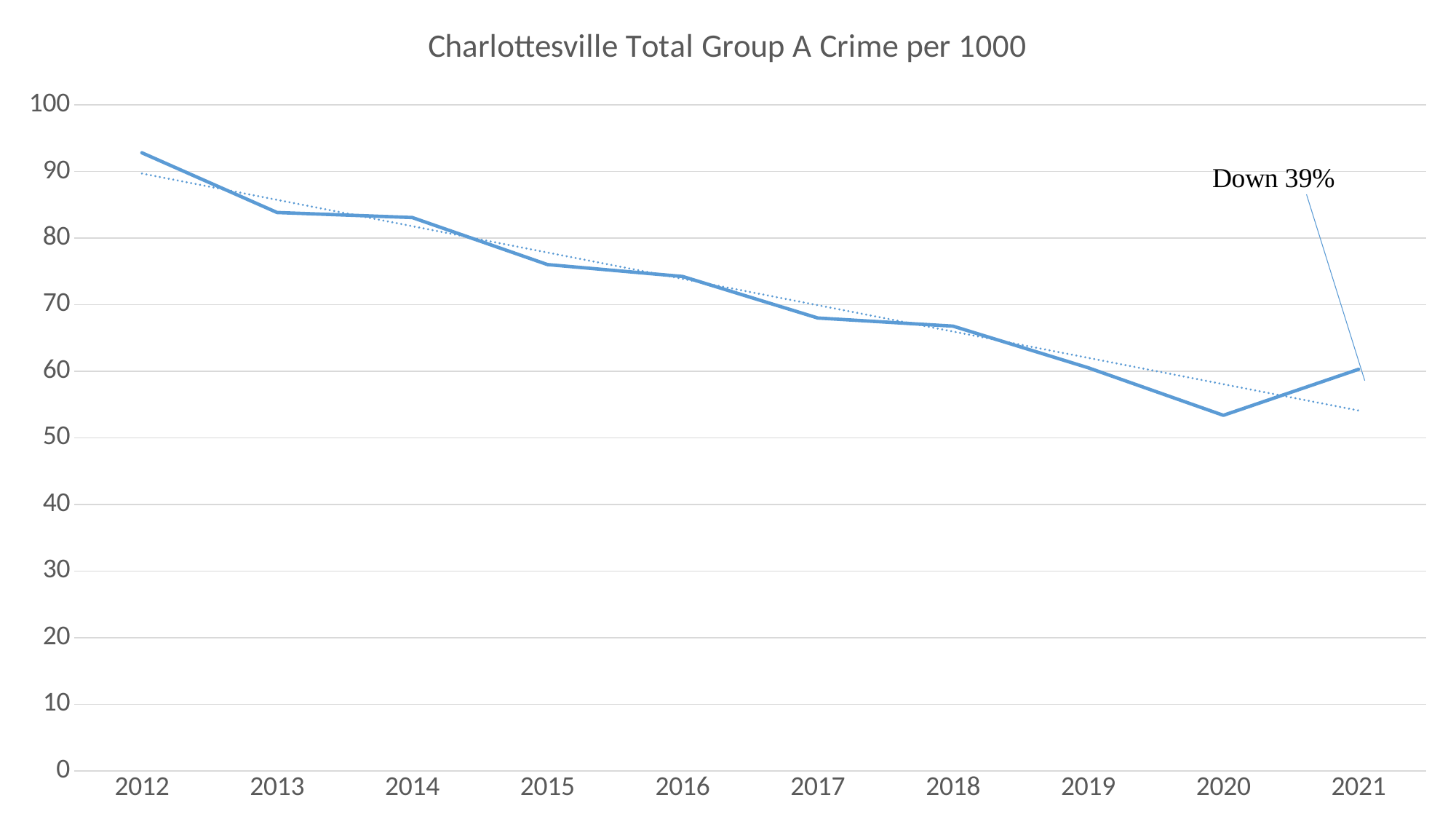
What does the annotation near the 2021 point say? Down 39% What kind of chart is shown on the slide? line chart Is the value for 2013 greater or less than 80? greater What is the title of the chart? Charlottesville Total Group A Crime per 1000 Which year has the lowest crime rate per 1000? 2020 Is the value for 2020 greater or less than 60? less Which year has the highest crime rate per 1000? 2012 Do the values generally rise or fall from 2012 to 2021? fall Is the value for 2015 greater or less than 70? greater How many years are plotted along the x axis? 10 Which year has the larger value, 2012 or 2021? 2012